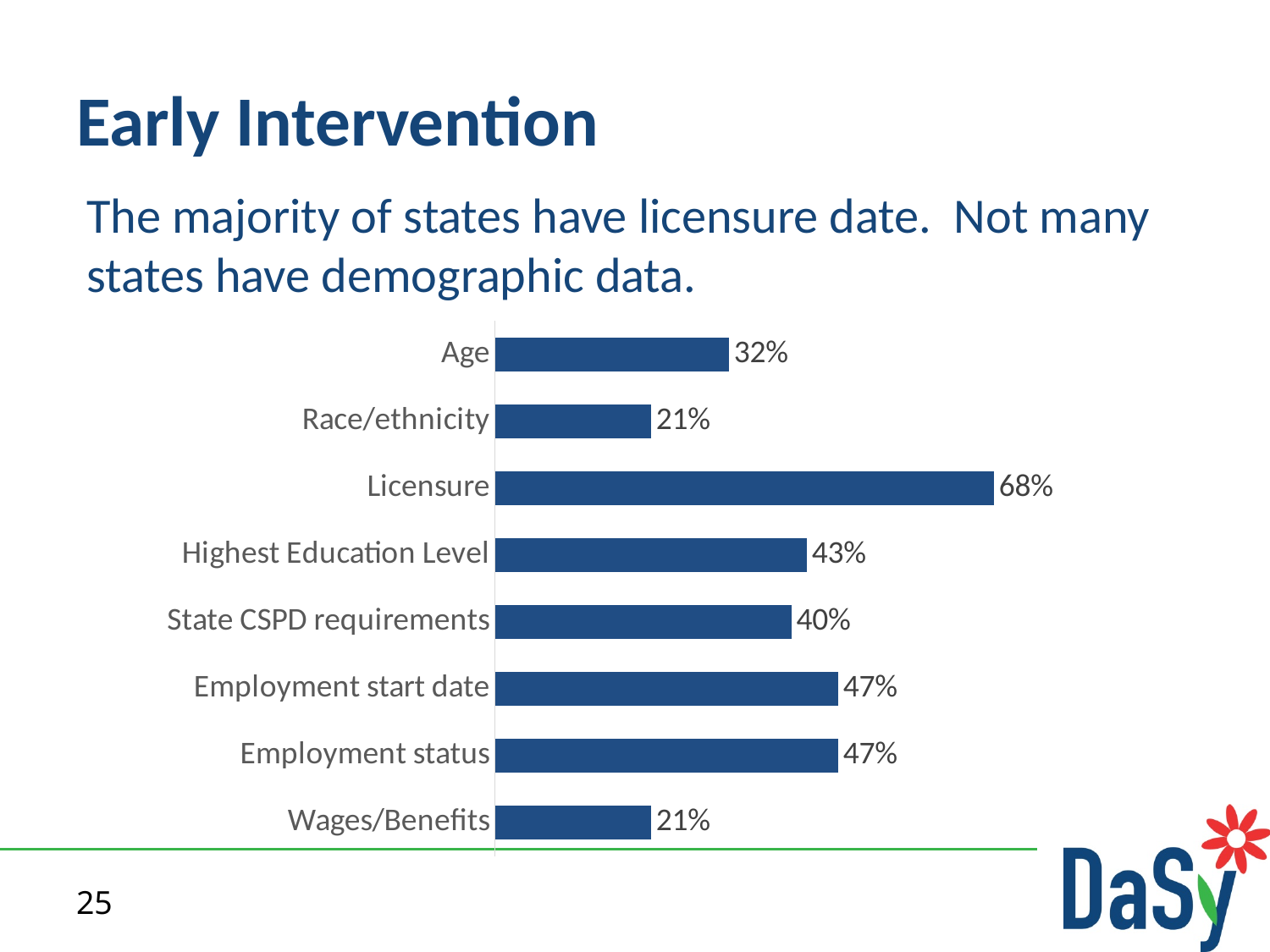
Which categories share the lowest value of 21%? Race/ethnicity and Wages/Benefits How many categories are shown in the chart? 8 What is the value for State CSPD requirements? 40% What is the difference between the values for Employment start date and State CSPD requirements? 7% Which category has the highest value? Licensure What is the value for Licensure? 68% What is the value for Employment status? 47% What kind of chart is shown on the slide? Bar chart What is the difference between the values for Licensure and Age? 36% Which is larger, the value for Highest Education Level or the value for Age? Highest Education Level What is the value for Age? 32% What is the value for Highest Education Level? 43%